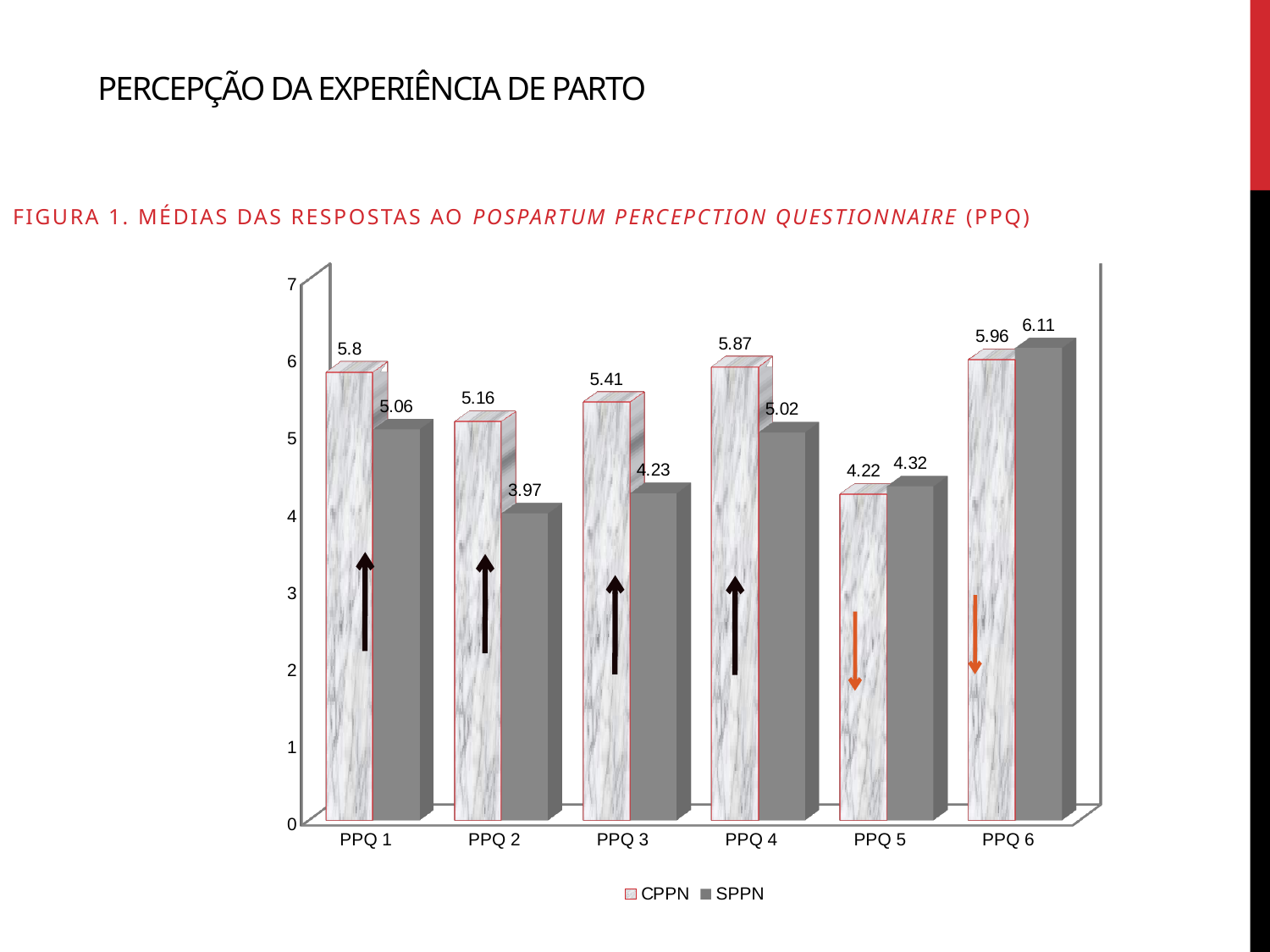
What is the difference between the CPPN and SPPN values for PPQ 3? 1.18 What kind of chart is shown on the slide? Bar chart Which category has the highest CPPN value? PPQ 6 What is the SPPN value for PPQ 2? 3.97 Which category has the lowest SPPN value? PPQ 2 What is the CPPN value for PPQ 1? 5.8 For PPQ 5, which series has the larger value, CPPN or SPPN? SPPN What is the difference between the SPPN values for PPQ 6 and PPQ 2? 2.14 How many categories are shown on the x axis? 6 What is the SPPN value for PPQ 6? 6.11 How many series does the legend list? 2 What are the two series named in the legend? CPPN and SPPN